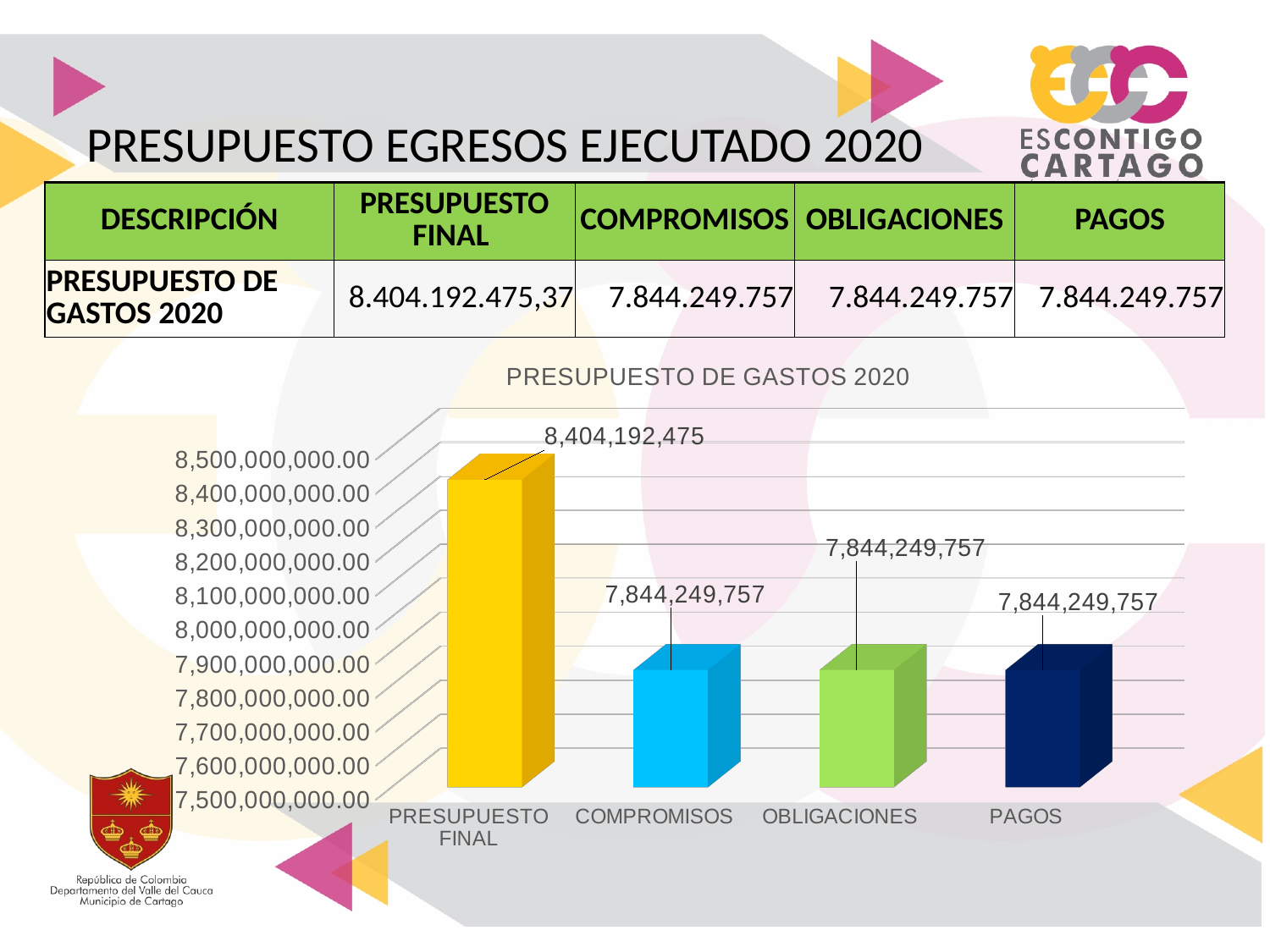
What is the difference between the values for PRESUPUESTO FINAL and COMPROMISOS? 559,942,718 What is the title of the chart? PRESUPUESTO DE GASTOS 2020 What is the value for OBLIGACIONES in the chart? 7,844,249,757 How many categories are shown on the x axis of the chart? 4 What is the value for COMPROMISOS in the chart? 7,844,249,757 What is the value for PAGOS in the chart? 7,844,249,757 Is the value for PRESUPUESTO FINAL greater or less than 8,000,000,000.00? greater What is the value for PRESUPUESTO FINAL in the chart? 8,404,192,475 Which category has the highest value in the chart? PRESUPUESTO FINAL Is the value for OBLIGACIONES greater or less than 8,000,000,000.00? less Which is larger, the value for PRESUPUESTO FINAL or the value for PAGOS? PRESUPUESTO FINAL What kind of chart is shown on the slide? bar chart